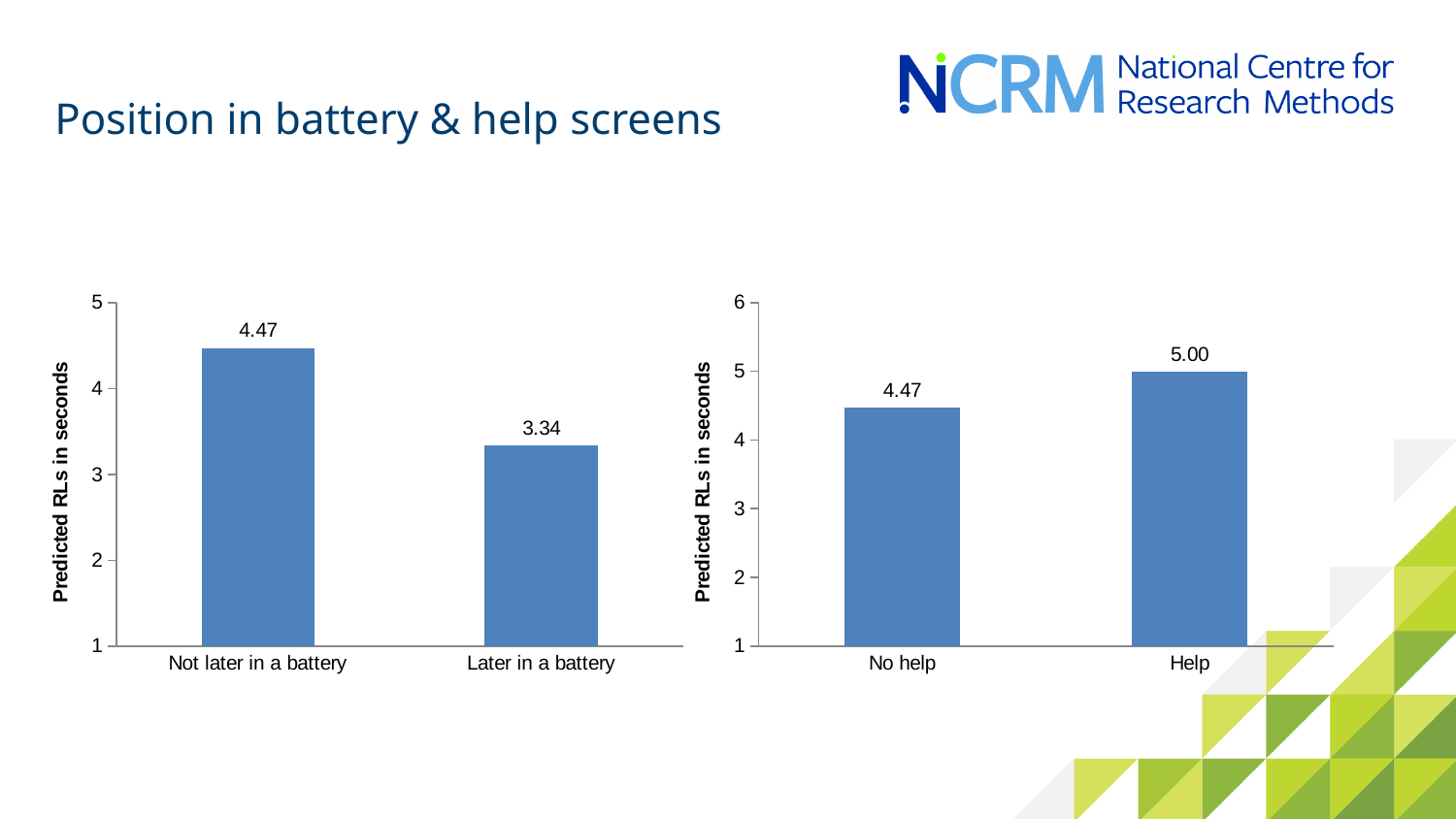
In the right chart, which category has the lower predicted RL? No help In the right chart, is the value for 'Help' greater or less than 4? greater In the left chart, what is the predicted RL in seconds for 'Not later in a battery'? 4.47 In the right chart, what is the predicted RL in seconds for 'No help'? 4.47 What type of chart is the right chart? Bar chart In the right chart, what is the difference in predicted RLs between 'Help' and 'No help'? 0.53 What is the y-axis label of the left chart? Predicted RLs in seconds In the left chart, what is the difference in predicted RLs between 'Not later in a battery' and 'Later in a battery'? 1.13 In the left chart, what is the predicted RL in seconds for 'Later in a battery'? 3.34 In the right chart, what is the predicted RL in seconds for 'Help'? 5.00 How many categories are shown in the left chart? 2 In the left chart, which category has the higher predicted RL? Not later in a battery